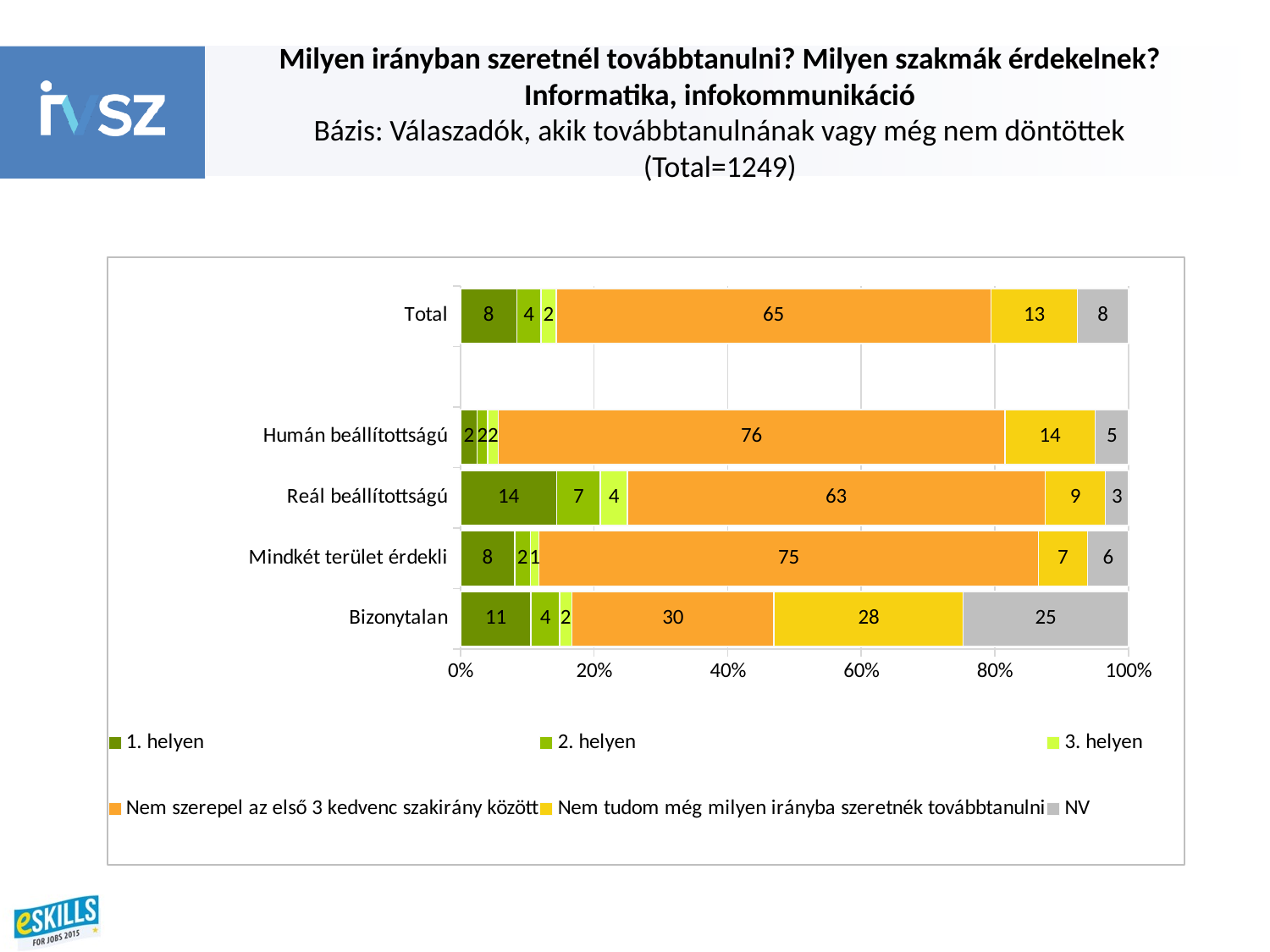
Which series is shown in grey in the legend? NV What is the value of 'Nem szerepel az első 3 kedvenc szakirány között' for Humán beállítottságú? 76 Which category has the lowest value for 'Nem szerepel az első 3 kedvenc szakirány között'? Bizonytalan How many series does the legend list? 6 What is the value of '1. helyen' for Reál beállítottságú? 14 What is the value of 'NV' for Bizonytalan? 25 What is the value of 'Nem tudom még milyen irányba szeretnék továbbtanulni' for Total? 13 What kind of chart is shown on the slide? Stacked bar chart What is the difference between the 'Nem szerepel az első 3 kedvenc szakirány között' values for Humán beállítottságú and Reál beállítottságú? 13 How many categories are plotted on the chart? 5 Which is larger: the 'Nem tudom még milyen irányba szeretnék továbbtanulni' value for Bizonytalan or for Total? Bizonytalan Which category has the highest value for '1. helyen'? Reál beállítottságú